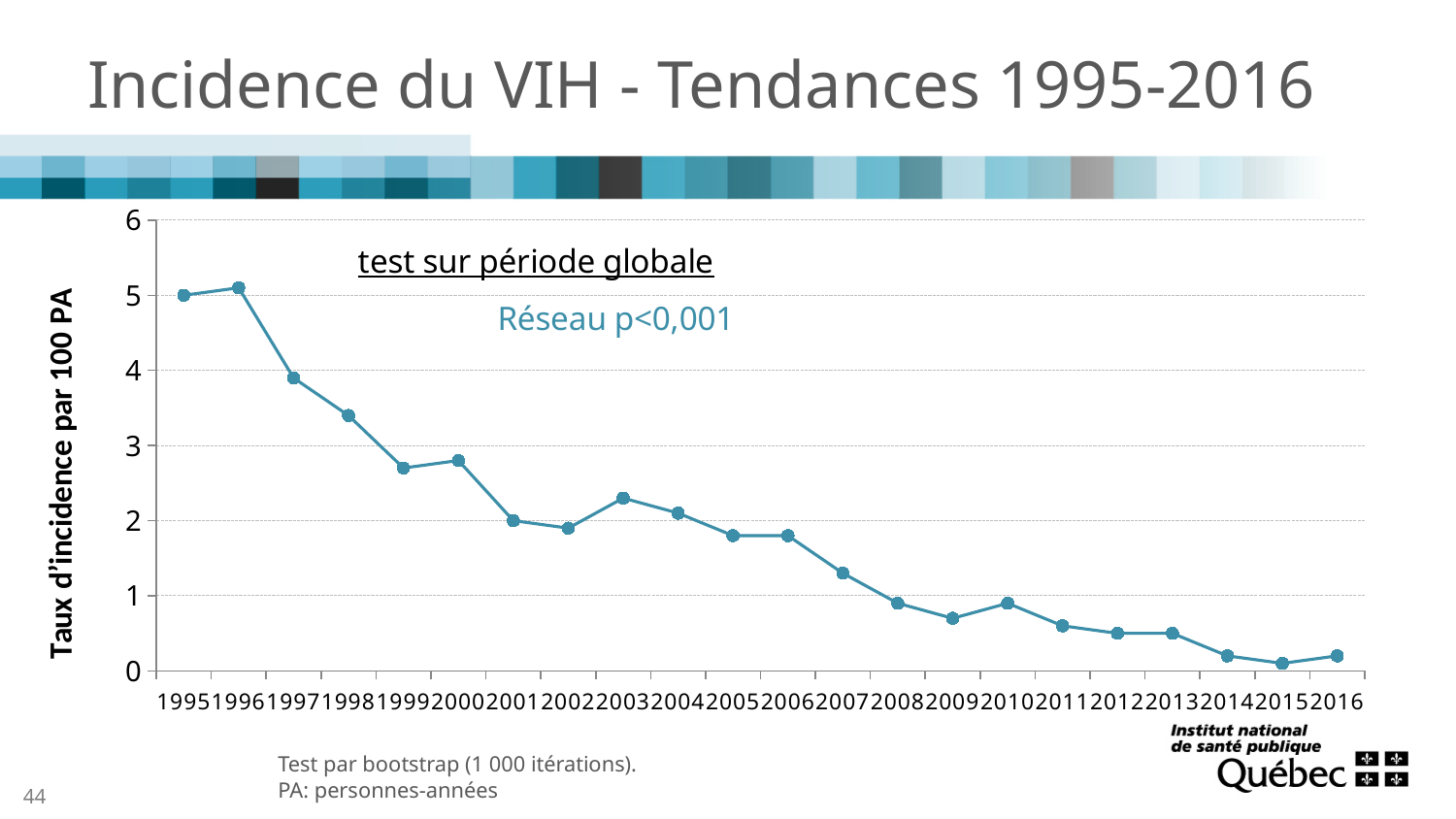
Is the value for 1997 greater or less than 3? greater What is the label of the y axis? Taux d'incidence par 100 PA Is the value for 1999 greater or less than 3? less Do the incidence rates generally rise or fall from 1995 to 2016? fall Which year has the larger incidence rate, 1997 or 2007? 1997 What p-value is stated in the annotation on the chart for 'Réseau'? p<0,001 How many years (data points) are plotted on the x axis? 22 What kind of chart is shown on the slide? line chart Is the value for 2003 greater or less than 2? greater What is the incidence rate per 100 PA in 1995? 5 Which year has the highest incidence rate? 1996